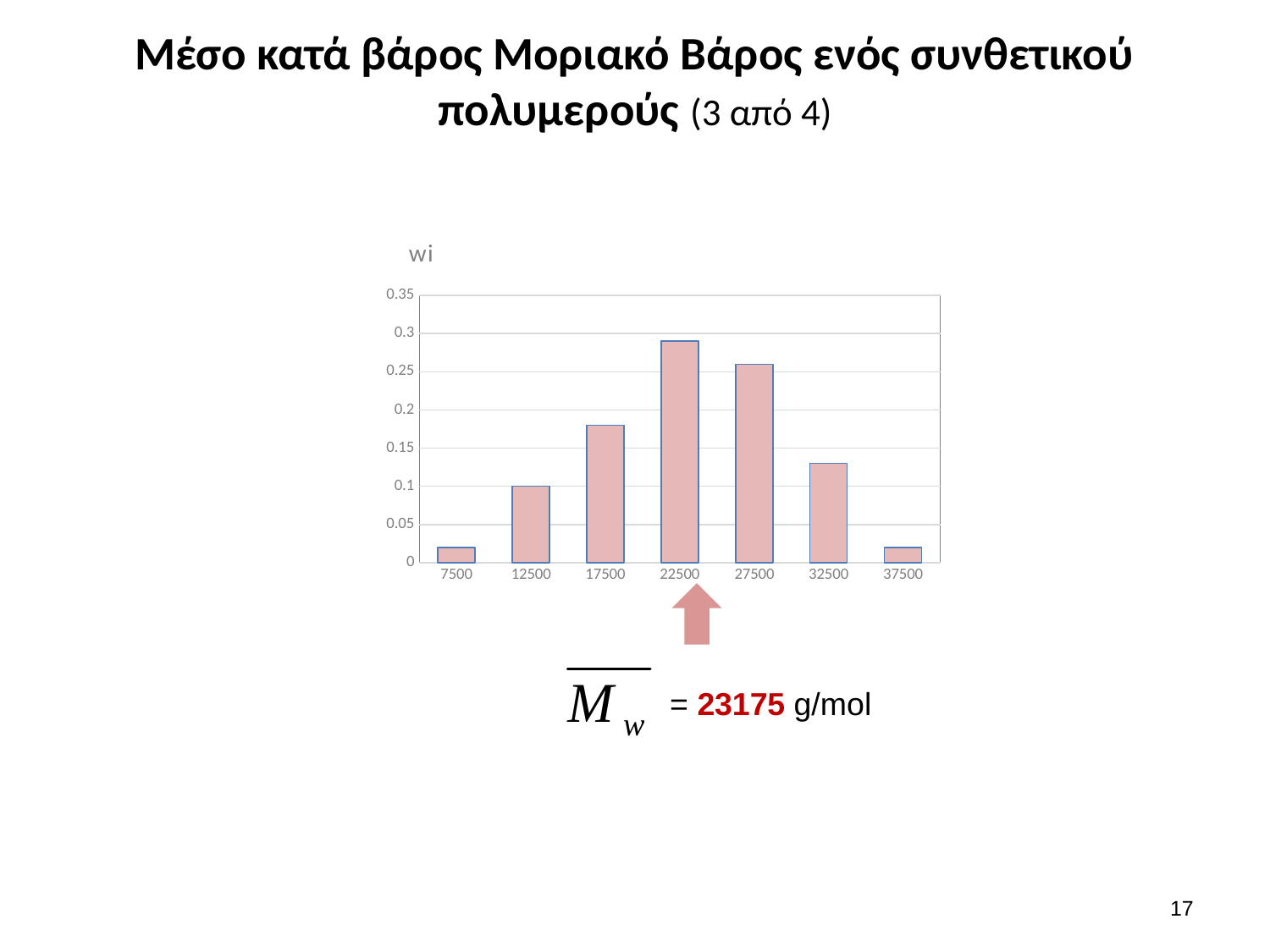
Is the value for 27500 greater or less than 0.2? greater Which has the larger value, 12500 or 22500? 22500 What is the title of the chart? wi Is the value for 22500 greater or less than 0.25? greater What kind of chart is shown on the slide? bar chart Is the value for 32500 greater or less than 0.15? less Which has the larger value, 17500 or 27500? 27500 Which category has the highest bar in the chart? 22500 How many categories are plotted on the x axis of the chart? 7 Do the values rise or fall from 22500 to 37500 along the x axis? fall